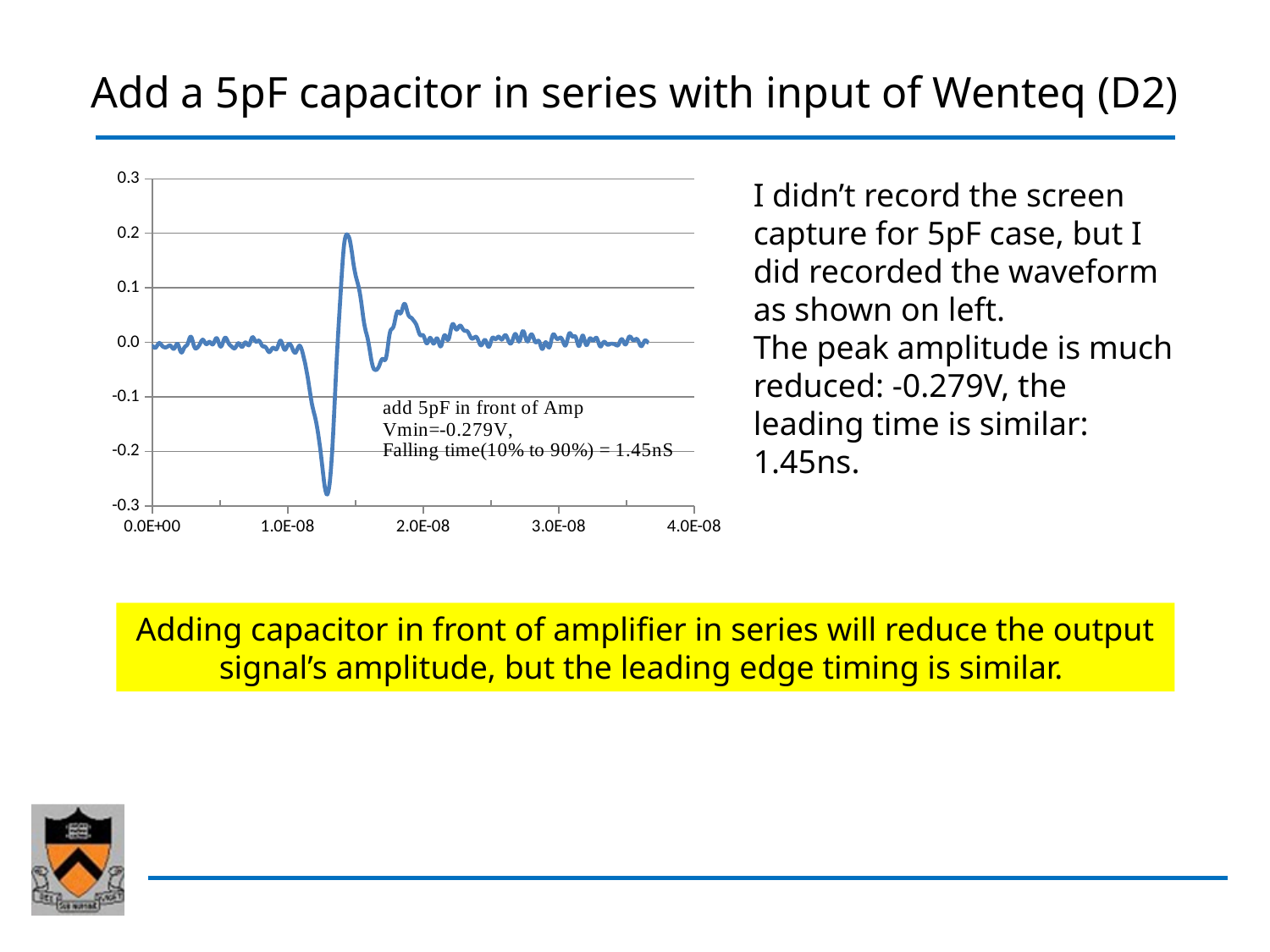
Does the large negative dip of the waveform occur before or after 2.0E-08 on the x axis? before What is the largest tick label shown on the x axis? 4.0E-08 According to the annotation on the chart, what is the falling time (10% to 90%)? 1.45nS How many lines are plotted on the chart? 1 Is the highest positive peak of the waveform greater or less than 0.3? less Is the lowest point of the waveform greater or less than -0.2? less Is the highest positive peak of the waveform greater or less than 0.1? greater What kind of chart is shown on the slide? line chart According to the annotation on the chart, what is Vmin? -0.279V What is the highest value shown on the y axis? 0.3